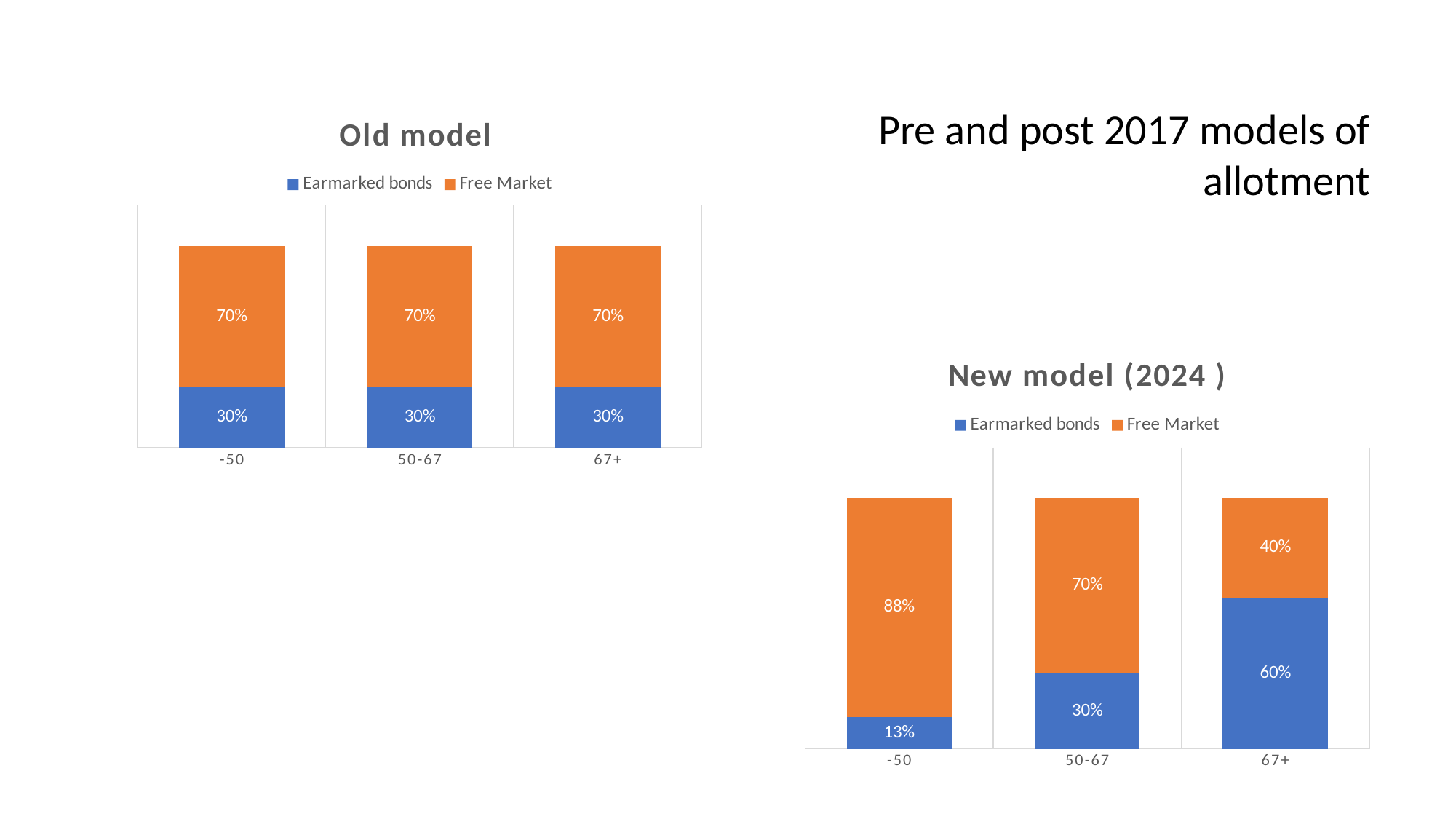
In the 'New model (2024 )' chart, which is larger for the 67+ category: Earmarked bonds or Free Market? Earmarked bonds In the 'New model (2024 )' chart, do the Earmarked bonds values rise or fall from -50 to 67+? Rise How many series does the legend of the 'New model (2024 )' chart list? 2 In the 'Old model' chart, what is the value for Free Market in the -50 category? 70% How many categories are shown on the x axis of the 'Old model' chart? 3 In the 'New model (2024 )' chart, what is the difference between the Free Market values for -50 and 50-67? 18% In the 'New model (2024 )' chart, which category has the highest Earmarked bonds value? 67+ In the 'Old model' chart, what is the value for Earmarked bonds in the 67+ category? 30% What kind of chart is the 'Old model' chart? Stacked bar chart In the 'New model (2024 )' chart, what is the value for Free Market in the 67+ category? 40% In the 'New model (2024 )' chart, which category has the lowest Free Market value? 67+ In the 'New model (2024 )' chart, what is the value for Earmarked bonds in the -50 category? 13%